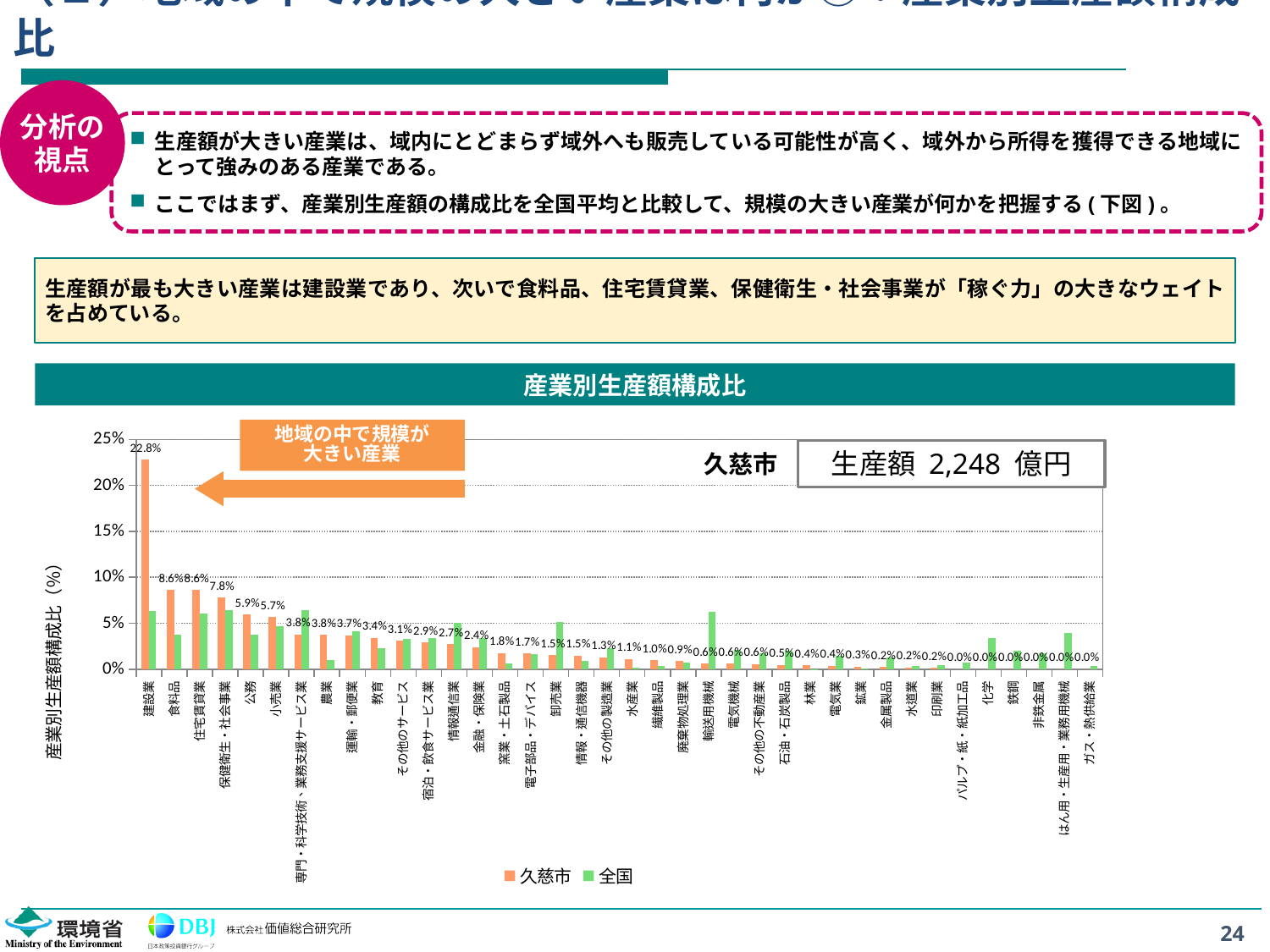
For 輸送用機械, which series has the larger value, 久慈市 or 全国? 全国 What is the 久慈市 value for 小売業? 5.7% What is the 久慈市 value for 情報通信業? 2.7% For 建設業, which series has the larger value, 久慈市 or 全国? 久慈市 How many series does the legend list? 2 What is the 久慈市 value for 建設業 in the 産業別生産額構成比 chart? 22.8% What is the difference between the 久慈市 values for 公務 and 小売業? 0.2% Which industry has the highest 久慈市 share in the chart? 建設業 What is the 久慈市 value for 保健衛生・社会事業? 7.8% What kind of chart is shown on the slide? bar chart What is the difference between the 久慈市 values for 建設業 and 食料品? 14.2% Is the 全国 value for 建設業 greater or less than 5%? greater